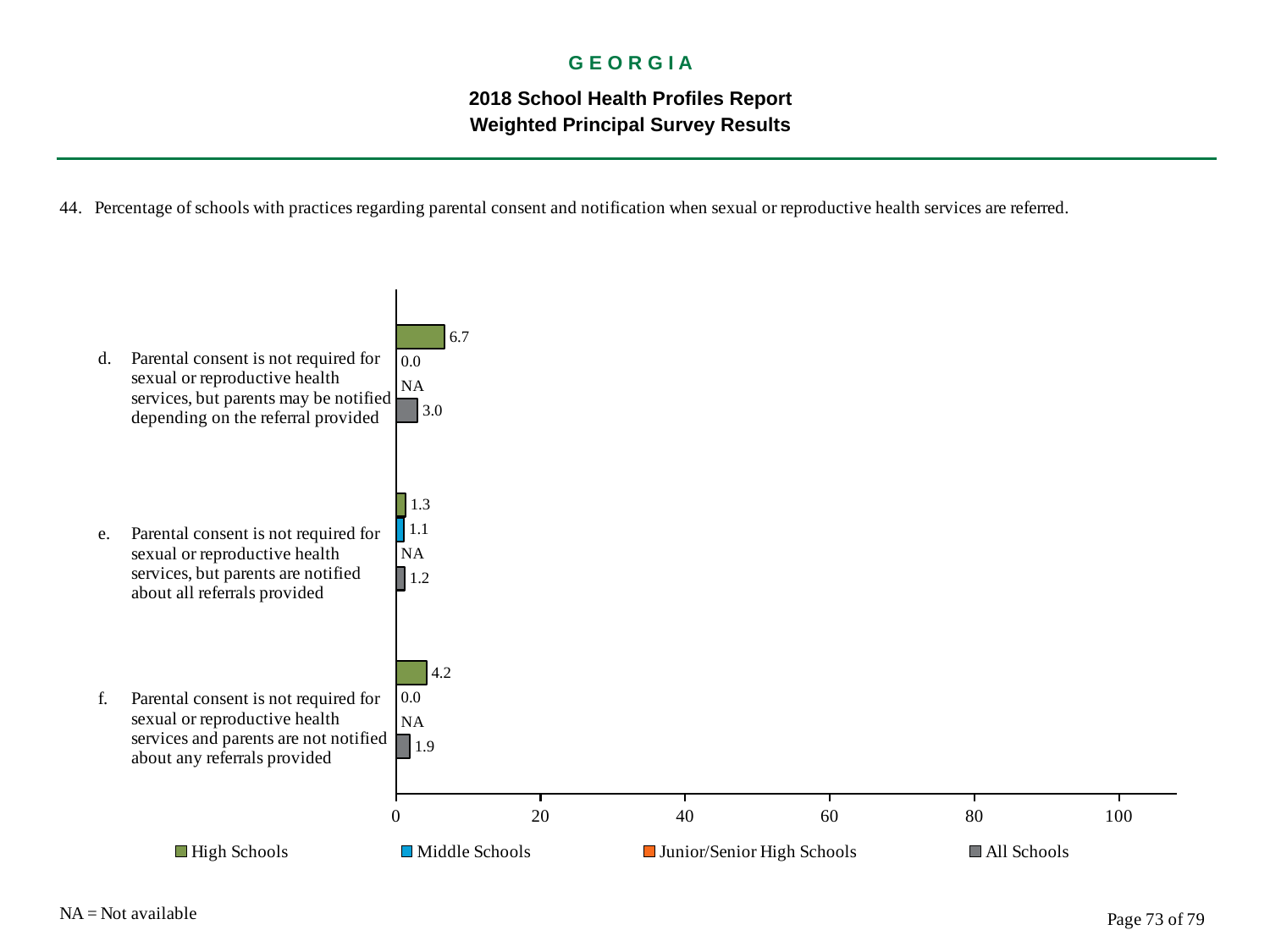
What is the All Schools value for practice f (parental consent not required and parents are not notified about any referrals provided)? 1.9 What is the Junior/Senior High Schools value for practice d? NA Which practice (d, e, or f) has the highest High Schools value? d Is the High Schools value for practice d greater or less than 20? less Which is larger for practice f: the High Schools value or the All Schools value? High Schools How many series does the legend list? 4 What is the Middle Schools value for practice e (parental consent not required, but parents are notified about all referrals provided)? 1.1 What does NA stand for according to the note on the slide? Not available Which practice (d, e, or f) has the lowest All Schools value? e What kind of chart is shown on the slide? bar chart What is the High Schools value for practice d (parental consent not required, but parents may be notified depending on the referral provided)? 6.7 What is the difference between the High Schools value and the All Schools value for practice d? 3.7